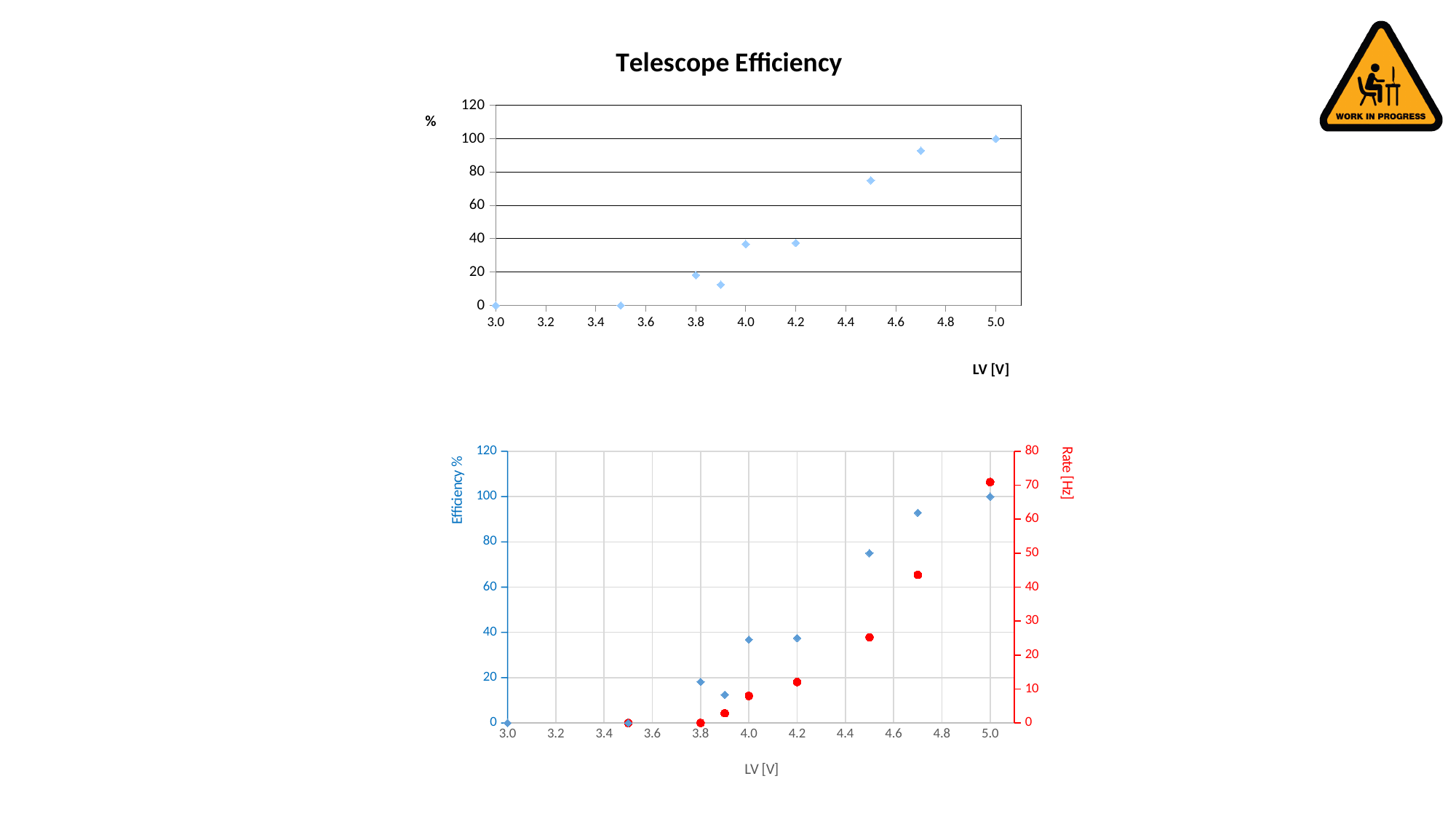
In the bottom chart, is the Rate [Hz] value at LV = 5.0 V greater or less than 60? greater In the bottom chart, what is the label of the right-hand (red) vertical axis? Rate [Hz] In the top chart 'Telescope Efficiency', is the value at LV = 3.8 V greater or less than 20? less In the top chart 'Telescope Efficiency', what is the efficiency value at LV = 3.5 V? 0 What kind of chart is the top chart titled 'Telescope Efficiency'? scatter chart In the bottom chart, is the Rate [Hz] value at LV = 4.5 V greater or less than 30? less In the top chart 'Telescope Efficiency', how many data points are plotted? 9 In the top chart 'Telescope Efficiency', at which LV value is the efficiency highest? 5.0 In the top chart 'Telescope Efficiency', do the values generally rise or fall as LV increases? rise What is the title of the top chart? Telescope Efficiency In the top chart 'Telescope Efficiency', which is larger: the value at LV = 4.7 V or at LV = 4.2 V? 4.7 V